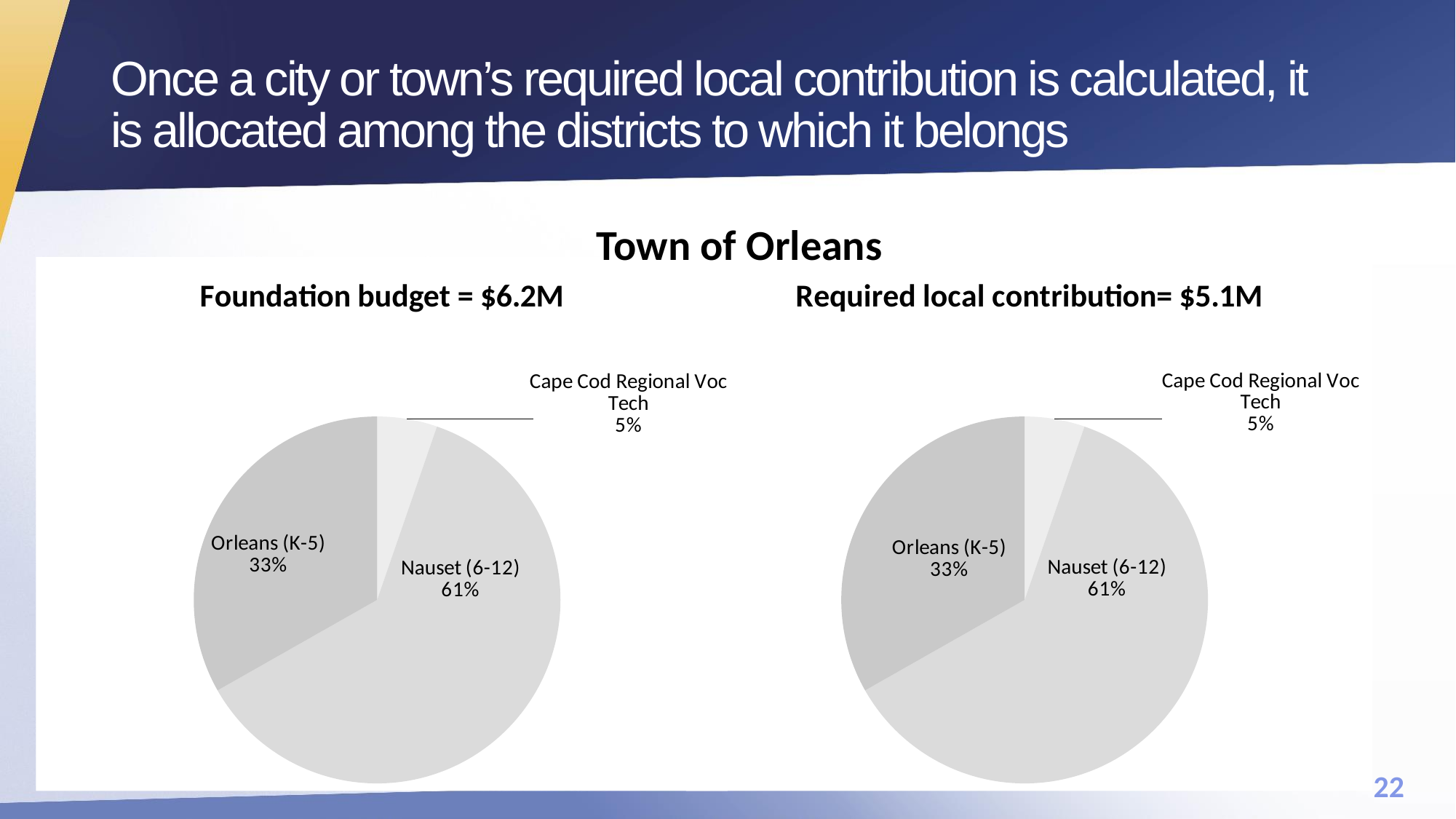
In the Foundation budget pie chart, what share does Nauset (6-12) have? 61% In the Required local contribution pie chart, what is the difference in percentage points between Orleans (K-5) and Cape Cod Regional Voc Tech? 28 In the Required local contribution pie chart, which district has the largest slice? Nauset (6-12) What is the title of the right chart? Required local contribution= $5.1M What type of chart is used for the Required local contribution? Pie chart In the Foundation budget pie chart, what is the difference in percentage points between Nauset (6-12) and Orleans (K-5)? 28 In the Foundation budget pie chart, which district has the smallest slice? Cape Cod Regional Voc Tech What is the title of the left chart? Foundation budget = $6.2M In the Required local contribution pie chart, what share does Orleans (K-5) have? 33% In the Foundation budget pie chart, what share does Cape Cod Regional Voc Tech have? 5% In the Required local contribution pie chart, which is larger: Orleans (K-5) or Cape Cod Regional Voc Tech? Orleans (K-5) How many slices does the Foundation budget pie chart have? 3